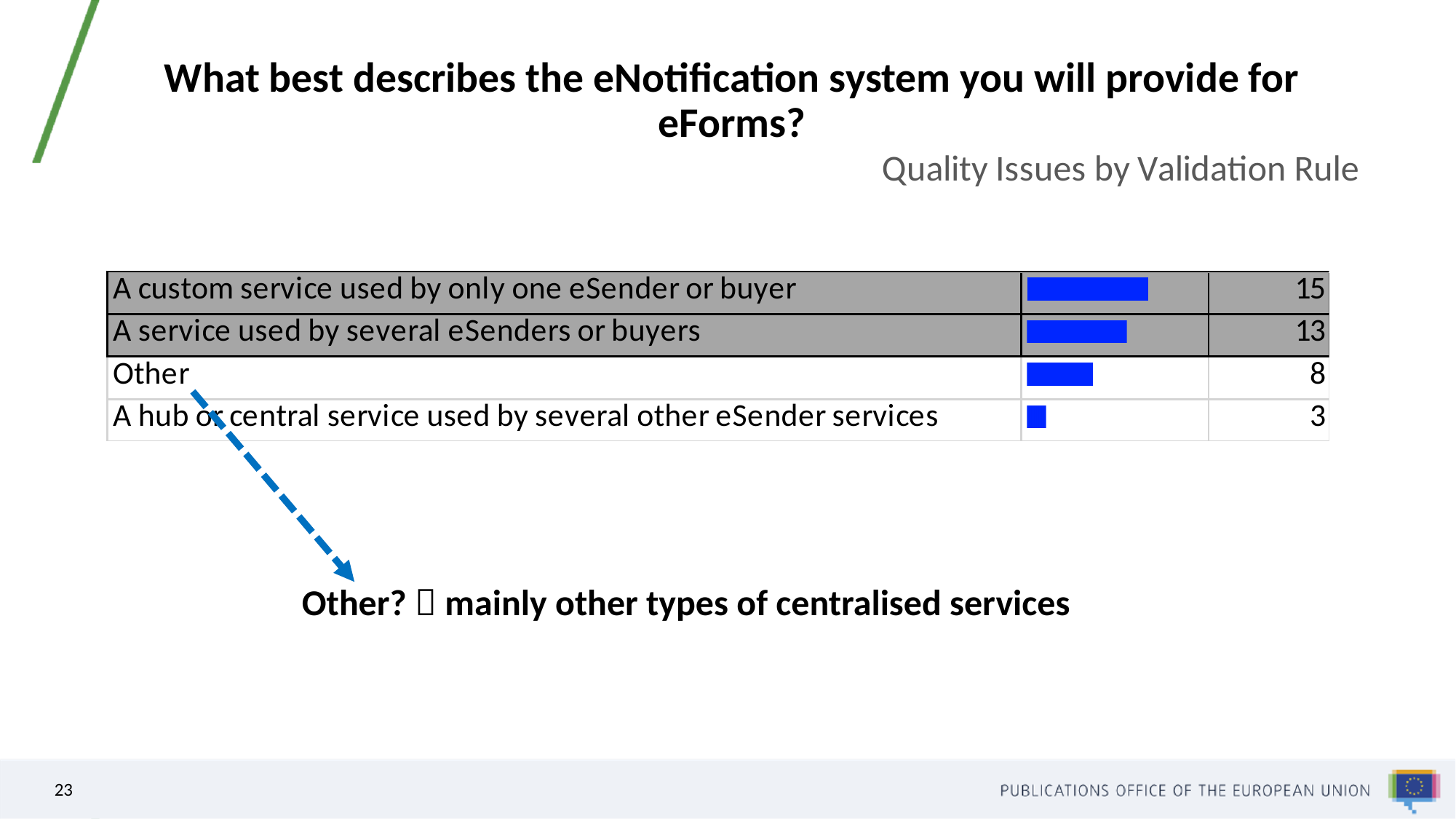
Which is larger: the value for "Other" or the value for "A hub or central service used by several other eSender services"? Other How many categories are shown in the chart? 4 Which category has the lowest value? A hub or central service used by several other eSender services What is the value for "A hub or central service used by several other eSender services"? 3 What kind of chart is shown on the slide? Bar chart What is the value for "A service used by several eSenders or buyers"? 13 What is the value for "Other"? 8 What is the difference between the values for "A custom service used by only one eSender or buyer" and "A service used by several eSenders or buyers"? 2 What is the difference between the values for "Other" and "A hub or central service used by several other eSender services"? 5 What is the total of all four values shown in the chart? 39 What is the value for "A custom service used by only one eSender or buyer"? 15 Which category has the highest value? A custom service used by only one eSender or buyer